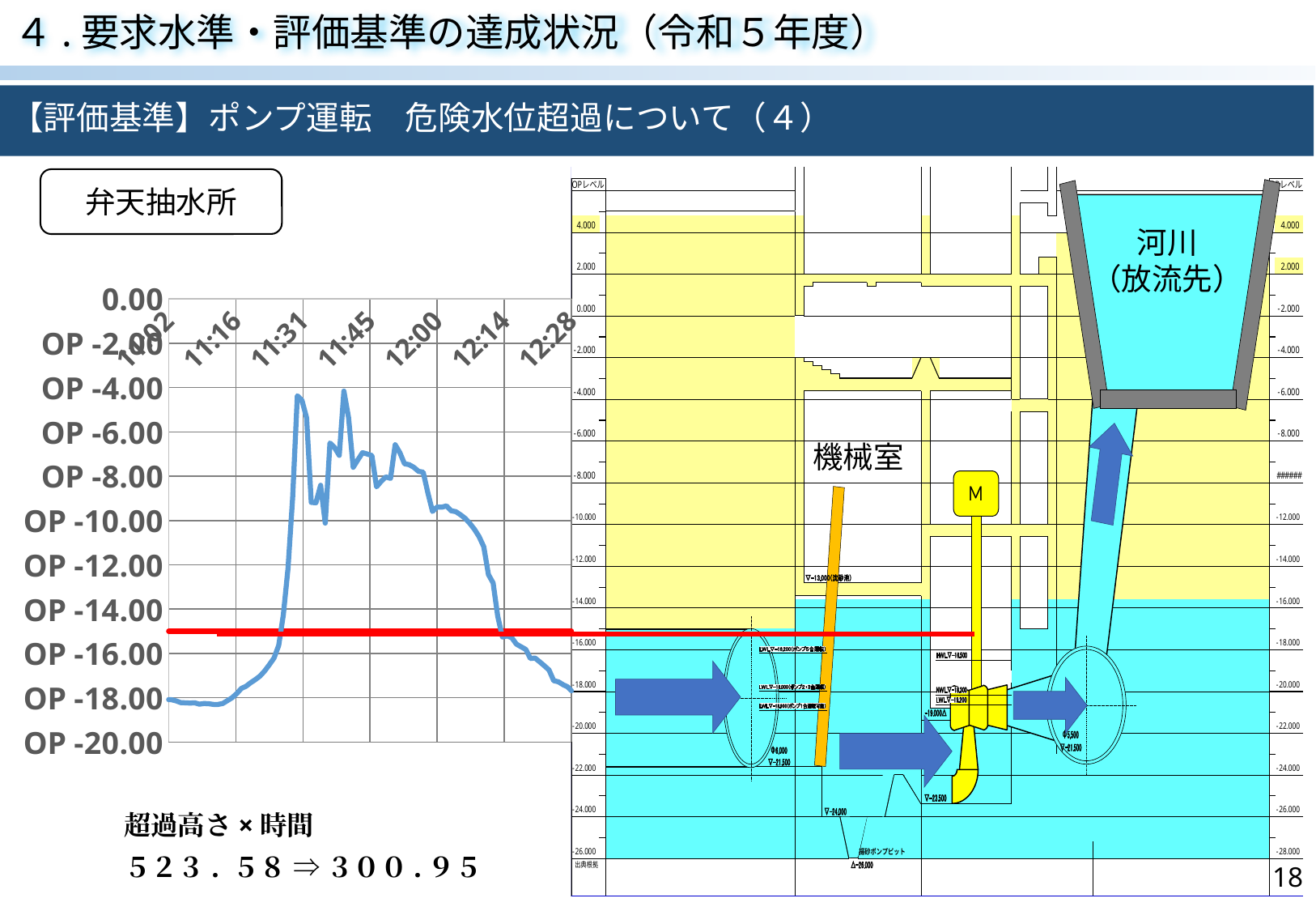
Is the highest point of the line greater or less than OP -6.00? greater Does the line rise or fall between 12:00 and 12:28? fall What kind of chart is shown on the left of the slide? line chart How many time labels are shown on the x axis of the line chart? 7 Is the red horizontal line on the chart above or below OP -14.00? below What is the first time label on the x axis of the line chart? 11:02 Is the value of the line at 11:02 greater or less than OP -16.00? less Does the line reach its highest point before or after 12:00? before What is the lowest label on the y axis of the line chart? OP -20.00 Does the line rise or fall between 11:16 and 11:31? rise